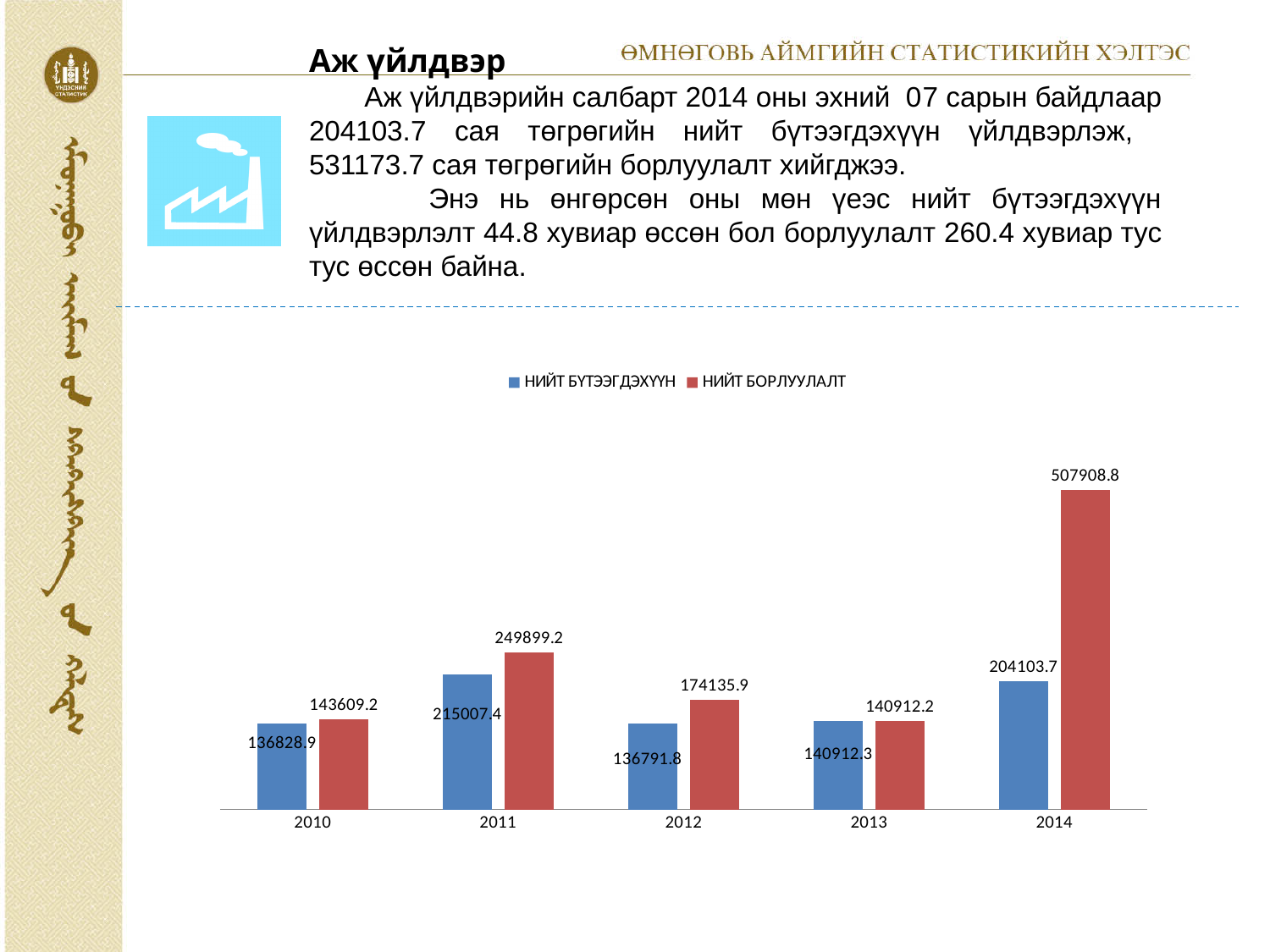
What is the difference between НИЙТ БОРЛУУЛАЛТ and НИЙТ БҮТЭЭГДЭХҮҮН in 2011? 34891.8 What is the value of НИЙТ БҮТЭЭГДЭХҮҮН for 2014? 204103.7 How many series does the chart legend list? 2 What kind of chart is shown on the slide? Bar chart In 2012, which is larger: НИЙТ БҮТЭЭГДЭХҮҮН or НИЙТ БОРЛУУЛАЛТ? НИЙТ БОРЛУУЛАЛТ What is the difference between НИЙТ БОРЛУУЛАЛТ and НИЙТ БҮТЭЭГДЭХҮҮН in 2014? 303805.1 In which year is НИЙТ БОРЛУУЛАЛТ highest? 2014 How many years are shown on the x axis of the chart? 5 What is the value of НИЙТ БОРЛУУЛАЛТ for 2014? 507908.8 What is the value of НИЙТ БОРЛУУЛАЛТ for 2012? 174135.9 In which year is НИЙТ БҮТЭЭГДЭХҮҮН highest? 2011 What is the value of НИЙТ БҮТЭЭГДЭХҮҮН for 2011? 215007.4